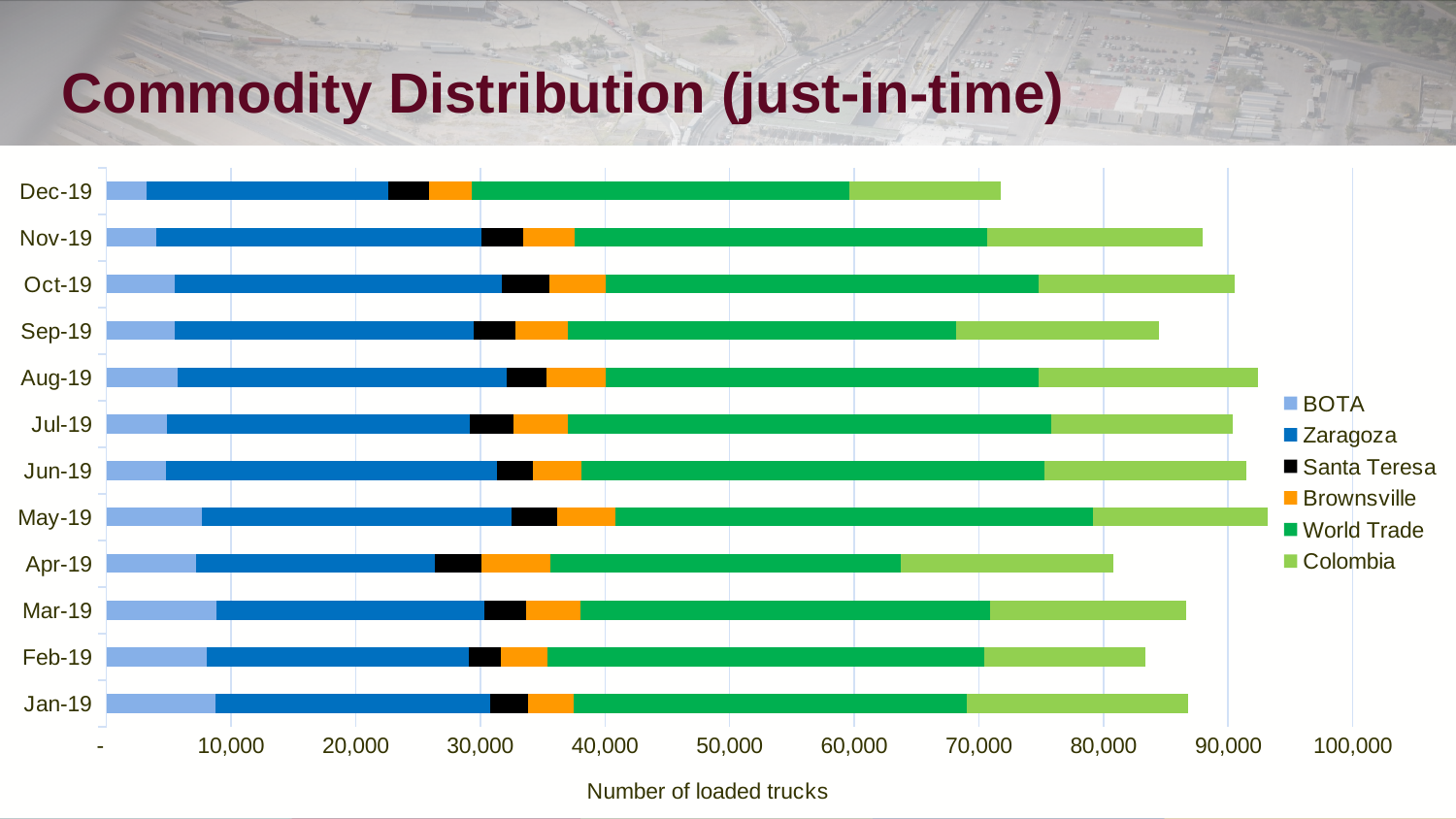
Is the total number of loaded trucks for May-19 greater or less than 90,000? greater How many months (categories) are plotted on the chart? 12 Which month has the larger total number of loaded trucks, Apr-19 or May-19? May-19 Which month has the larger total number of loaded trucks, Nov-19 or Dec-19? Nov-19 Is the total number of loaded trucks for Dec-19 greater or less than 80,000? less How many series does the legend list? 6 Is the total number of loaded trucks for Sep-19 greater or less than 90,000? less What kind of chart is shown on the slide? Stacked bar chart What is the title of the horizontal axis? Number of loaded trucks Which month has the lowest total number of loaded trucks? Dec-19 Which series is listed first in the legend? BOTA